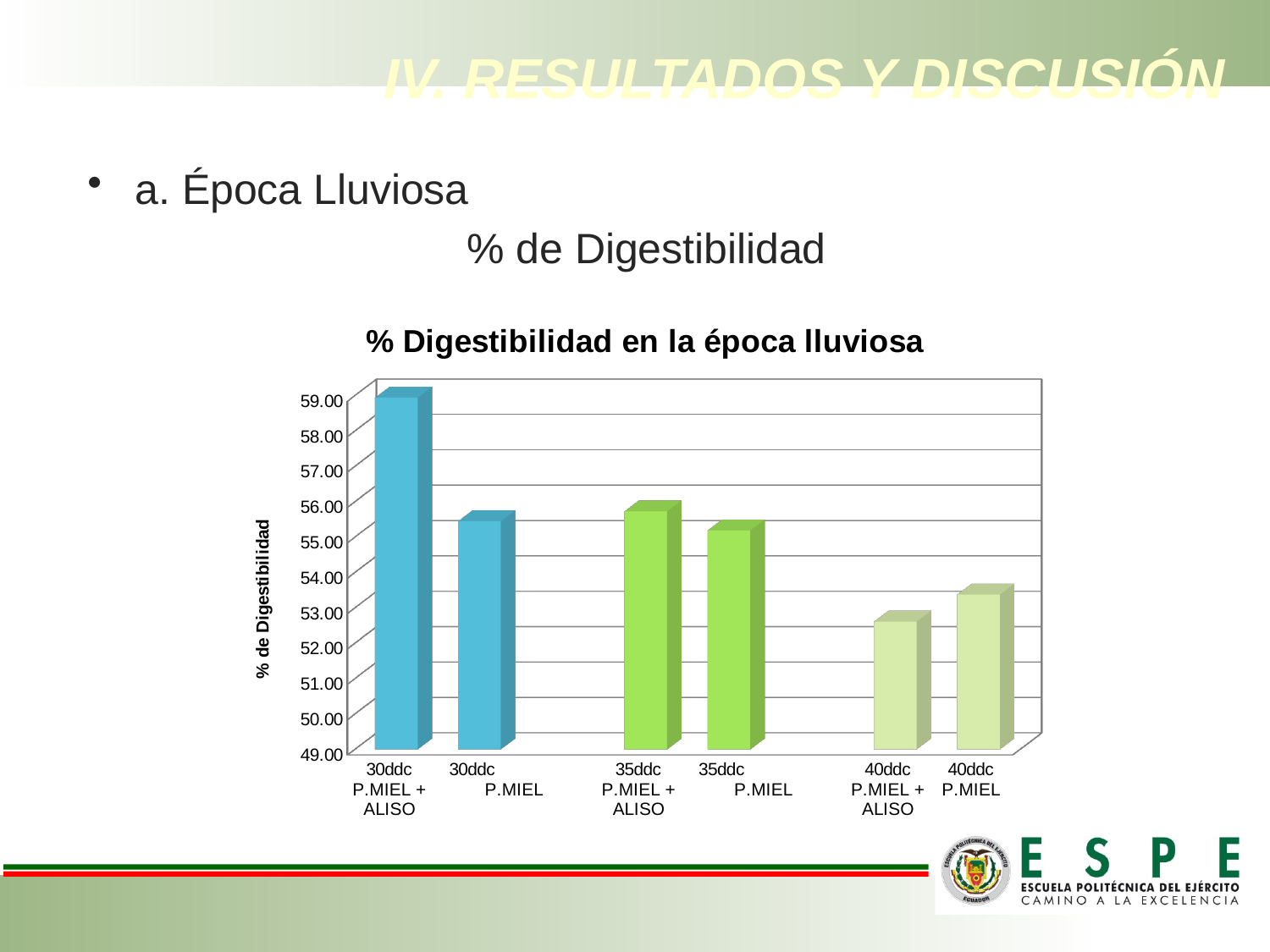
What type of chart is shown on the slide? bar chart Is the value for 40ddc P.MIEL + ALISO greater or less than 53.00? less What is the title of the chart? % Digestibilidad en la época lluviosa How many bars are plotted in the chart? 6 What is the label on the vertical axis of the chart? % de Digestibilidad Which is larger, the value for 30ddc P.MIEL + ALISO or the value for 30ddc P.MIEL? 30ddc P.MIEL + ALISO Is the value for 40ddc P.MIEL greater or less than 54.00? less Which category has the lowest % de Digestibilidad? 40ddc P.MIEL + ALISO Which category has the highest % de Digestibilidad? 30ddc P.MIEL + ALISO Is the value for 30ddc P.MIEL + ALISO greater or less than 58.00? greater Do the values for P.MIEL + ALISO rise or fall from 30ddc to 40ddc? fall